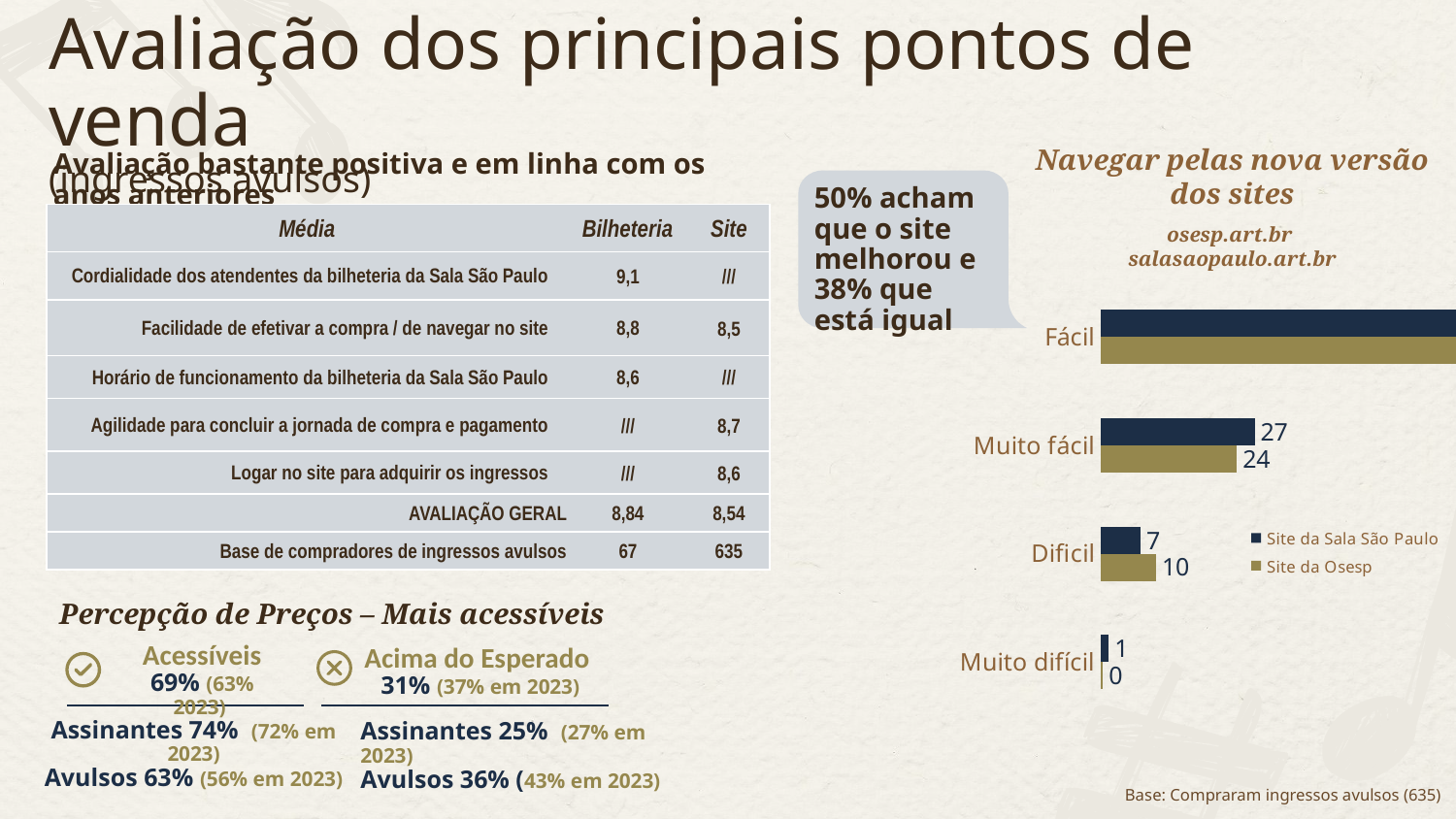
In the 'Navegar pelas nova versão dos sites' chart, what is the value for 'Dificil' for Site da Osesp? 10 In the 'Navegar pelas nova versão dos sites' chart, what is the difference between the 'Muito fácil' values for Site da Sala São Paulo and Site da Osesp? 3 How many categories are shown in the 'Navegar pelas nova versão dos sites' chart? 4 In the 'Navegar pelas nova versão dos sites' chart, which series is shown in dark navy? Site da Sala São Paulo How many series does the legend of the 'Navegar pelas nova versão dos sites' chart list? 2 In the 'Navegar pelas nova versão dos sites' chart, what is the value for 'Muito fácil' for Site da Sala São Paulo? 27 In the 'Navegar pelas nova versão dos sites' chart, which site has the larger value for 'Dificil'? Site da Osesp In the 'Navegar pelas nova versão dos sites' chart, which category has the lowest value for Site da Osesp? Muito difícil In the 'Navegar pelas nova versão dos sites' chart, what is the value for 'Muito fácil' for Site da Osesp? 24 In the 'Navegar pelas nova versão dos sites' chart, what is the value for 'Muito difícil' for Site da Sala São Paulo? 1 In the 'Navegar pelas nova versão dos sites' chart, which category has the highest value for Site da Sala São Paulo? Fácil What kind of chart is shown under the title 'Navegar pelas nova versão dos sites'? bar chart